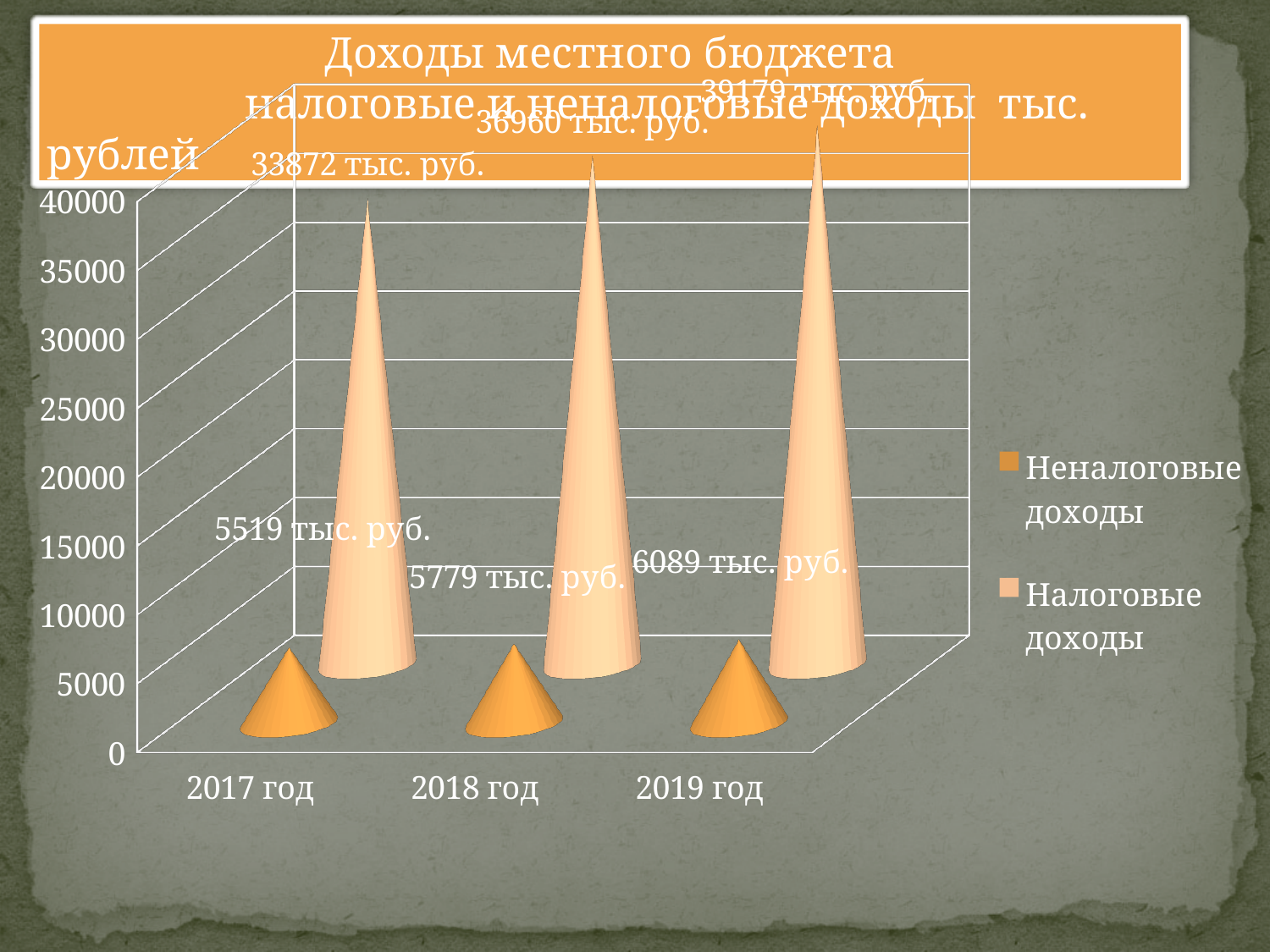
Is the value of Налоговые доходы for 2019 год greater or less than 35000? greater In which year is Налоговые доходы highest? 2019 год Do the values of Налоговые доходы rise or fall from 2017 год to 2019 год? rise What is the difference between Налоговые доходы in 2019 год and 2017 год? 5307 тыс. руб. What is the value of Налоговые доходы for 2017 год? 33872 тыс. руб. How many years are shown on the x axis? 3 Which is larger in 2018 год: Налоговые доходы or Неналоговые доходы? Налоговые доходы What is the value of Налоговые доходы for 2018 год? 36960 тыс. руб. What is the value of Неналоговые доходы for 2019 год? 6089 тыс. руб. How many series does the legend list? 2 In which year is Неналоговые доходы lowest? 2017 год What is the value of Неналоговые доходы for 2018 год? 5779 тыс. руб.